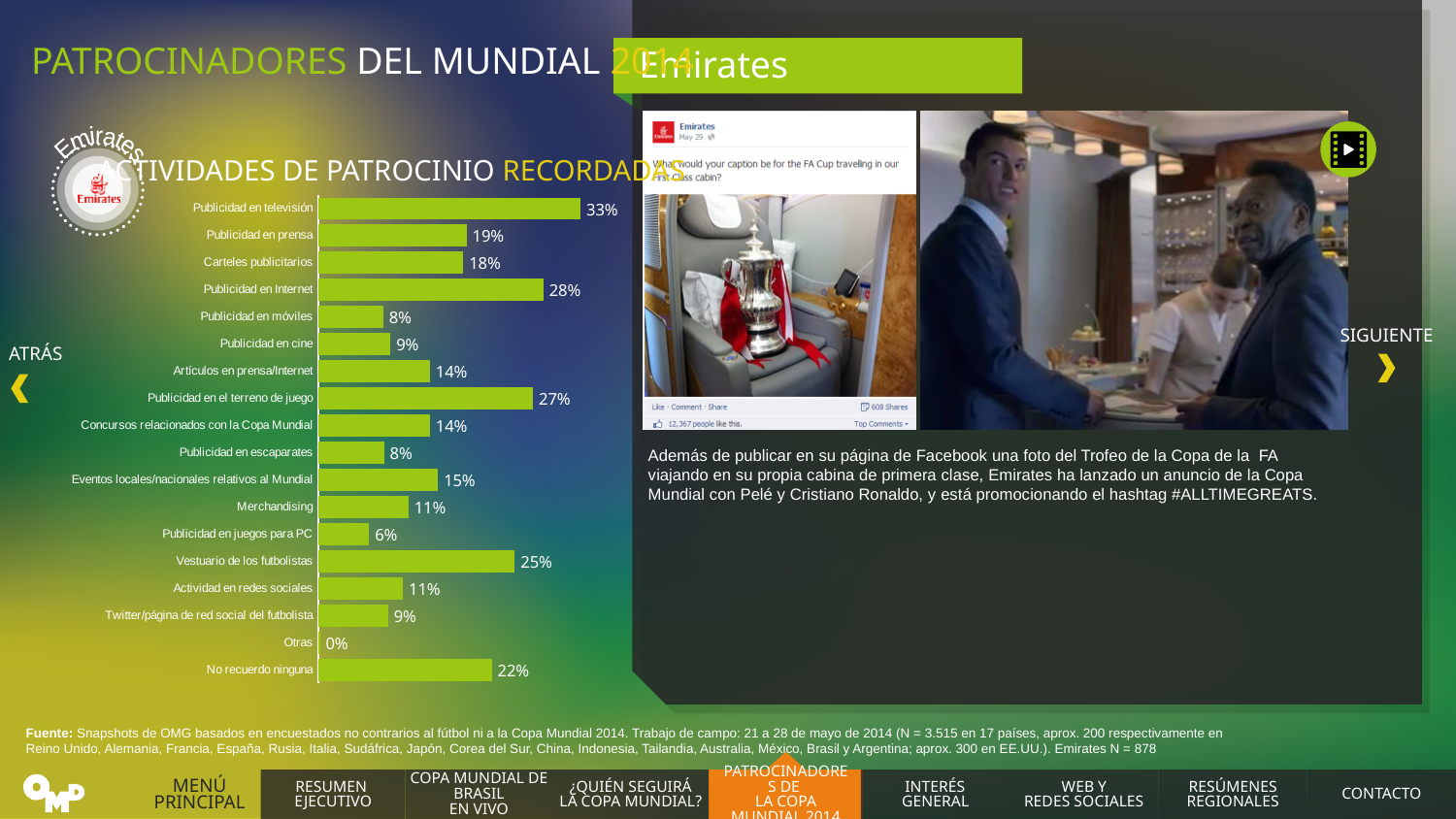
Which category has the highest value? Publicidad en televisión What kind of chart is shown? Bar chart What is the value for Publicidad en juegos para PC? 6% What is the value for Vestuario de los futbolistas? 25% What is the difference between Publicidad en televisión and Publicidad en el terreno de juego? 6% What is the value for No recuerdo ninguna? 22% What is the title of the chart? ACTIVIDADES DE PATROCINIO RECORDADAS Which is larger, Publicidad en prensa or Carteles publicitarios? Publicidad en prensa Which category has the lowest value? Otras How many categories does the chart show? 18 What is the value for Publicidad en televisión? 33% What is the value for Publicidad en Internet? 28%